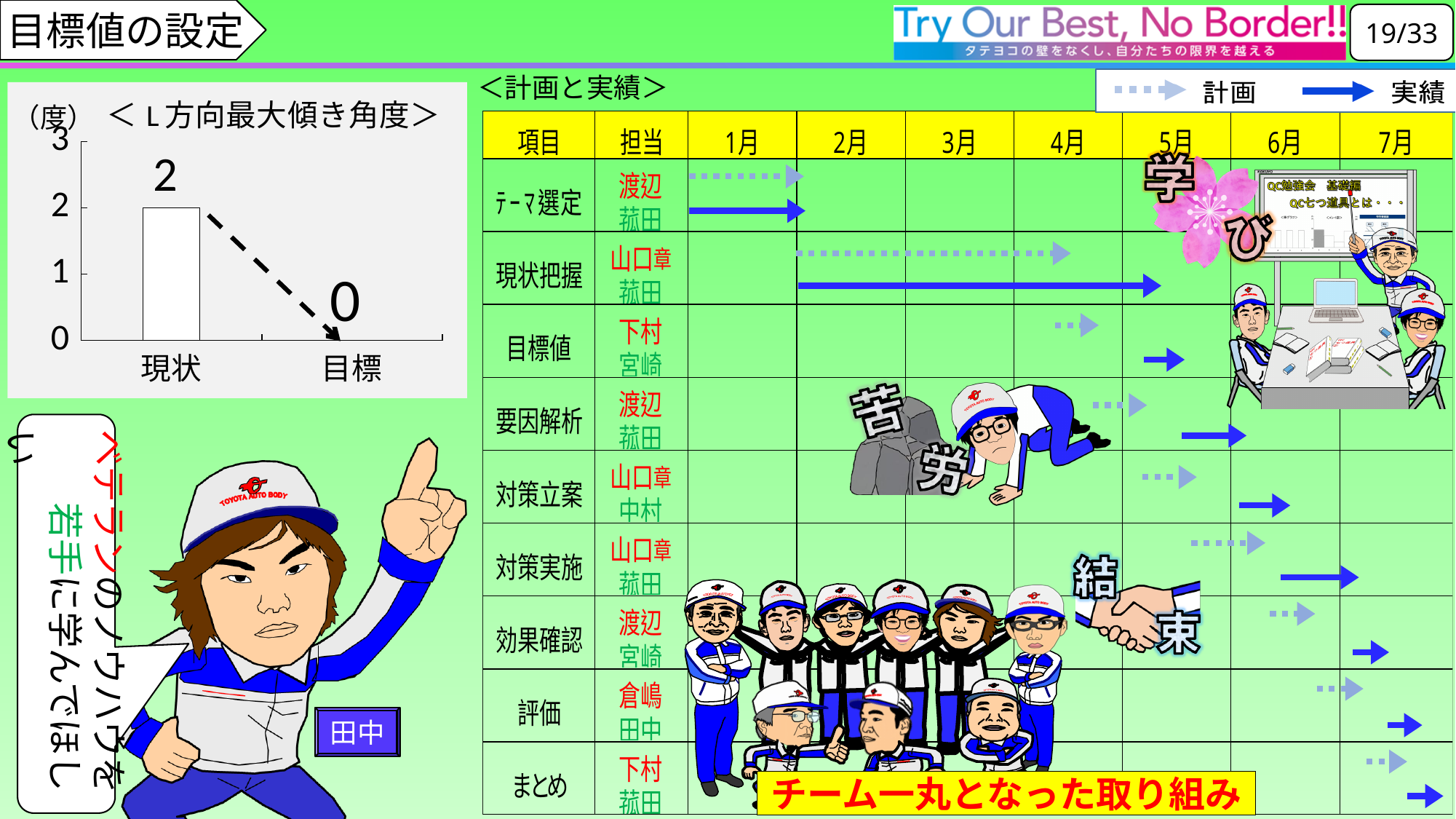
In the chart titled ＜L方向最大傾き角度＞, what is the value for 目標? 0 What kind of chart is the one titled ＜L方向最大傾き角度＞? bar chart In the chart titled ＜L方向最大傾き角度＞, what is the value for 現状? 2 In the chart titled ＜L方向最大傾き角度＞, which category has the higher value? 現状 In the chart titled ＜L方向最大傾き角度＞, how many categories are shown on the x axis? 2 In the chart titled ＜L方向最大傾き角度＞, what is the highest tick value on the y axis? 3 In the chart titled ＜L方向最大傾き角度＞, what is the difference between the 現状 value and the 目標 value? 2 In the chart titled ＜L方向最大傾き角度＞, what unit is shown on the y axis? 度 In the chart titled ＜L方向最大傾き角度＞, is the value for 現状 greater or less than 1? greater In the chart titled ＜L方向最大傾き角度＞, do the values rise or fall from 現状 to 目標? fall In the chart titled ＜L方向最大傾き角度＞, which category has the lowest value? 目標